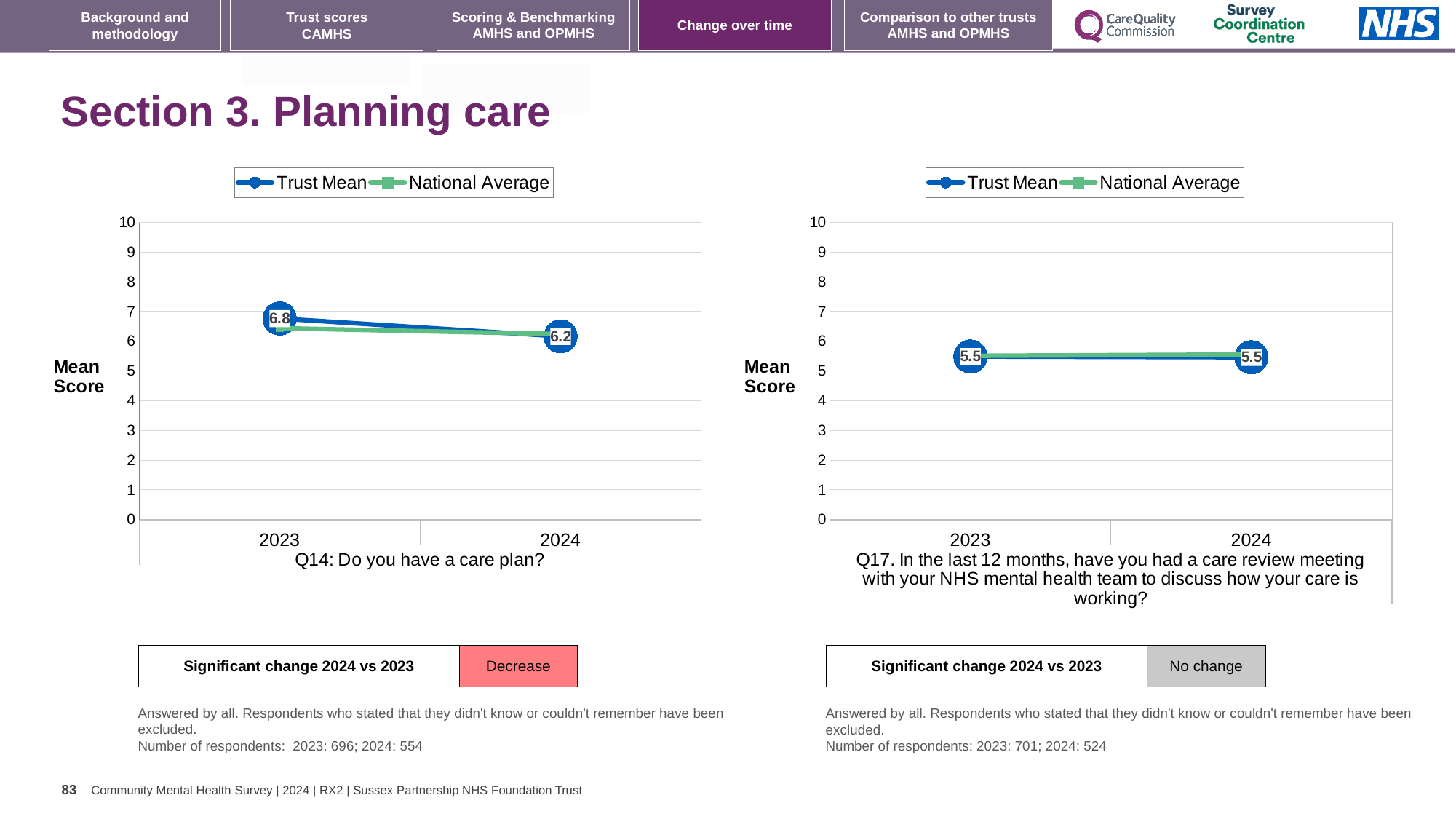
On the left chart (Q14: Do you have a care plan?), is the National Average for 2023 greater or less than 5? greater On the left chart (Q14: Do you have a care plan?), what is the Trust Mean for 2024? 6.2 On the left chart (Q14: Do you have a care plan?), by how much did the Trust Mean change from 2023 to 2024? 0.6 What kind of chart is the left chart (Q14: Do you have a care plan?)? line chart On the left chart (Q14: Do you have a care plan?), which year has the higher Trust Mean, 2023 or 2024? 2023 On the right chart (Q17, care review meeting), does the Trust Mean rise, fall or stay the same from 2023 to 2024? stay the same On the right chart (Q17, care review meeting), what is the Trust Mean for 2024? 5.5 How many series does the legend of the right chart (Q17) list? 2 On the left chart (Q14: Do you have a care plan?), what is the Trust Mean for 2023? 6.8 How many years are plotted on the x axis of the right chart (Q17)? 2 On the right chart (Q17, care review meeting), what is the Trust Mean for 2023? 5.5 On the left chart (Q14: Do you have a care plan?), does the Trust Mean rise or fall from 2023 to 2024? fall